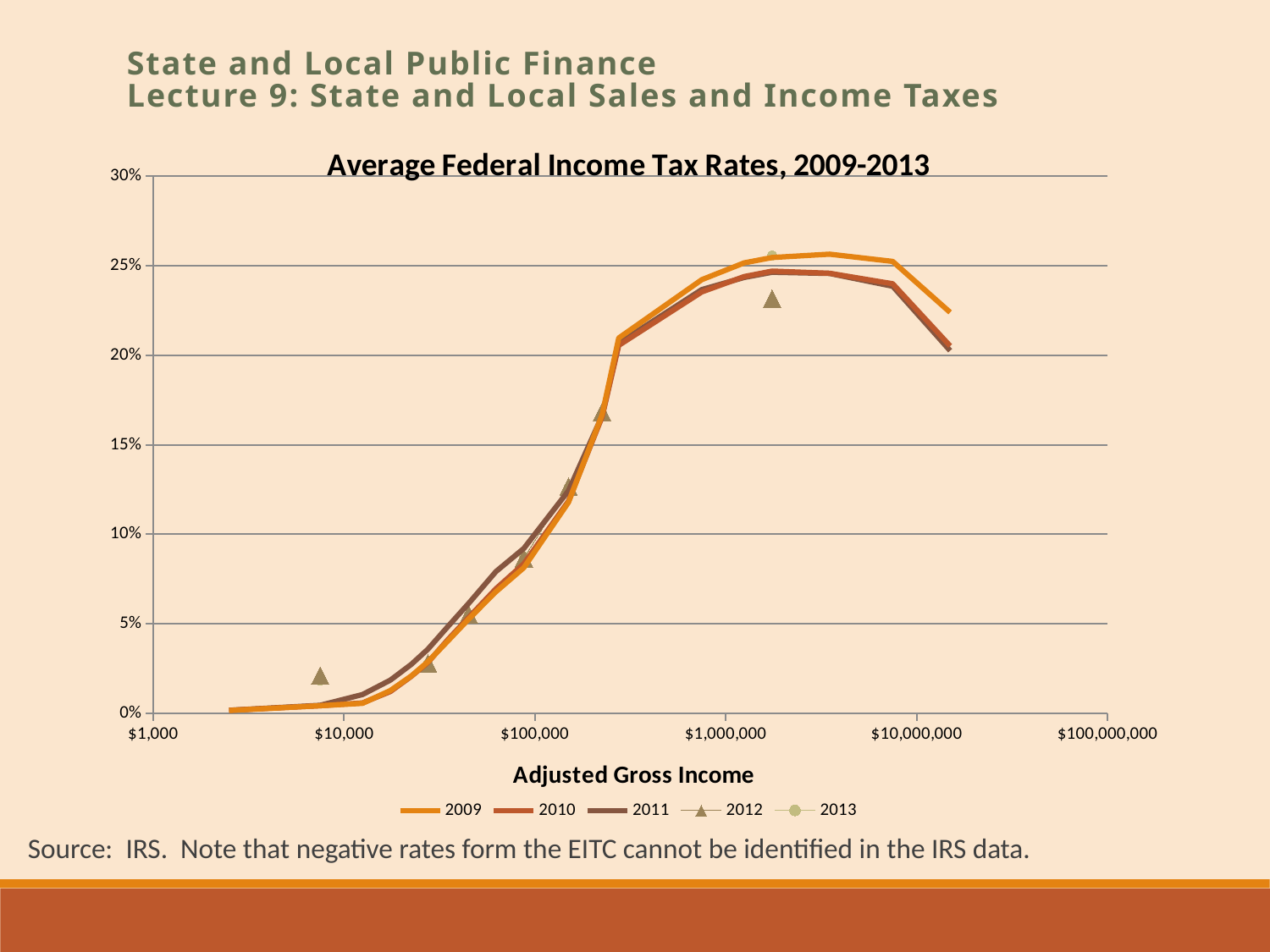
Is the 2009 average tax rate at $10,000 of adjusted gross income greater or less than 5%? less Do the average tax rates rise or fall as adjusted gross income increases from about $3,000,000 to the highest income plotted? fall What kind of chart is shown on the slide? line chart Do the average tax rates rise or fall as adjusted gross income increases from $10,000 to $1,000,000? rise At the highest income level plotted (just above $10,000,000), which series has the higher average tax rate, 2009 or 2011? 2009 Is the 2009 average tax rate at $1,000,000 of adjusted gross income greater or less than 20%? greater How many series does the legend list? 5 Is the highest point of the 2009 line greater or less than 25%? greater What is the label on the x axis of the chart? Adjusted Gross Income What is the title of the chart? Average Federal Income Tax Rates, 2009-2013